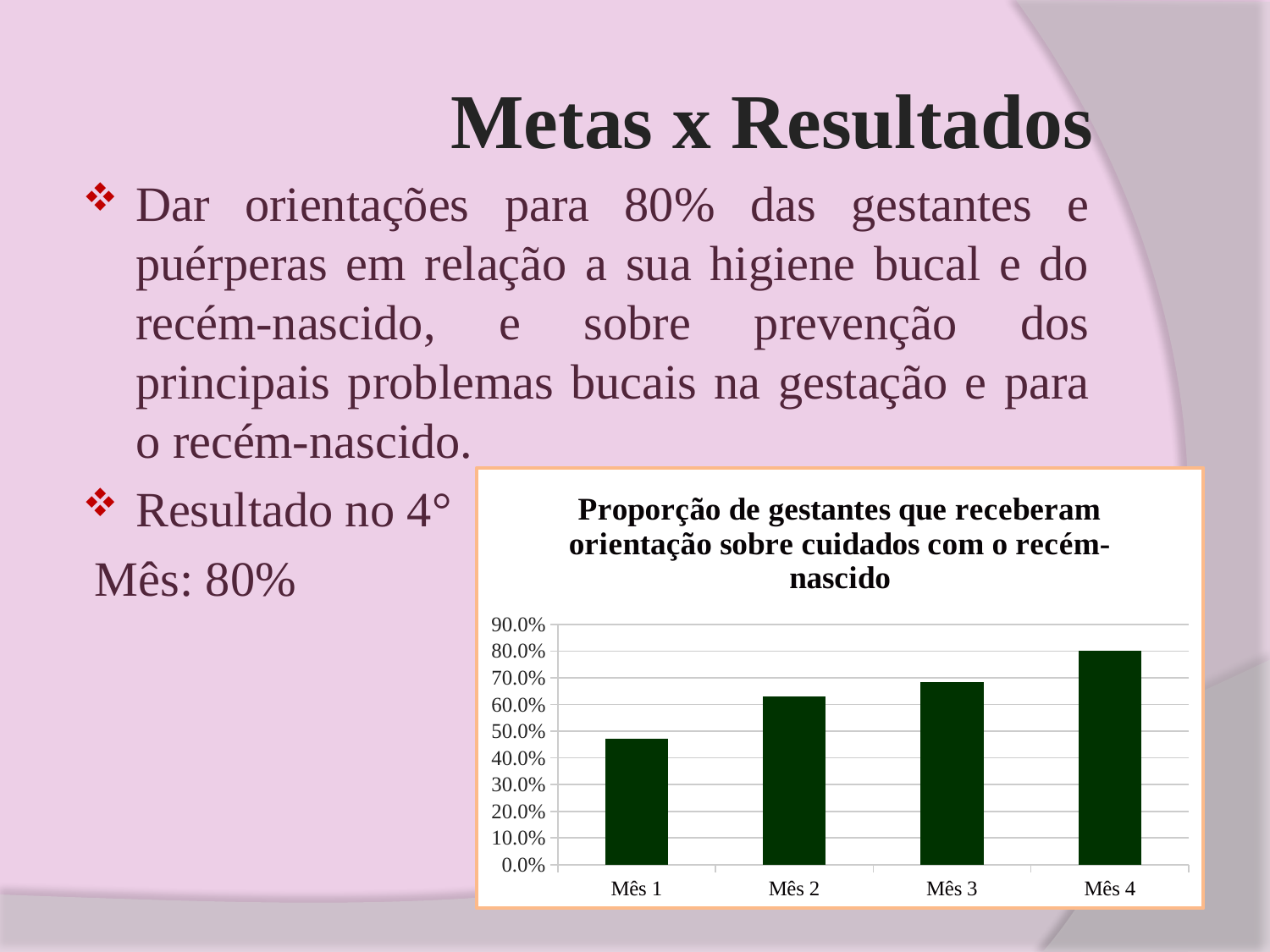
Do the values rise or fall from Mês 1 to Mês 4? rise Is the value for Mês 2 greater or less than 60.0%? greater What is the title of the chart? Proporção de gestantes que receberam orientação sobre cuidados com o recém-nascido Which month has the lowest proportion of pregnant women who received guidance? Mês 1 What kind of chart is shown on the slide? bar chart Is the value for Mês 4 greater or less than 70.0%? greater Is the value for Mês 1 greater or less than 50.0%? less Which month has the highest proportion of pregnant women who received guidance? Mês 4 Which is larger, the value for Mês 1 or the value for Mês 3? Mês 3 What is the value for Mês 4? 80.0% How many months (categories) are plotted on the chart? 4